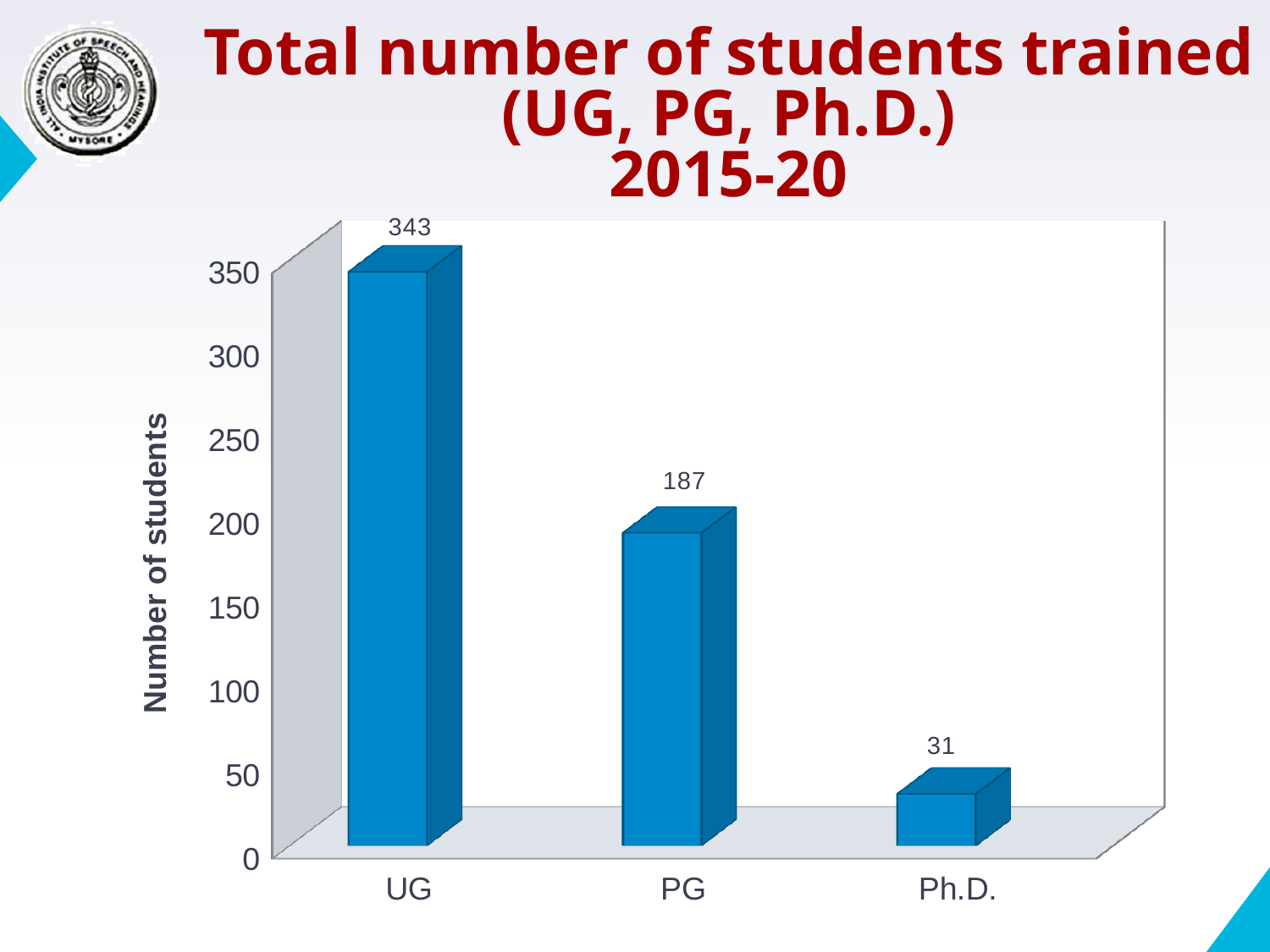
How many students were trained at the PG level? 187 Which category has the highest number of students trained? UG How many students were trained at the UG level? 343 Is the value for PG greater or less than 200? less What is the label of the vertical axis? Number of students What is the difference between the number of PG and Ph.D. students trained? 156 What kind of chart is shown on the slide? bar chart How many categories are shown on the x axis? 3 How many students were trained at the Ph.D. level? 31 Which category has the lowest number of students trained? Ph.D. Which is larger, the number of PG students or the number of Ph.D. students trained? PG What is the difference between the number of UG and PG students trained? 156